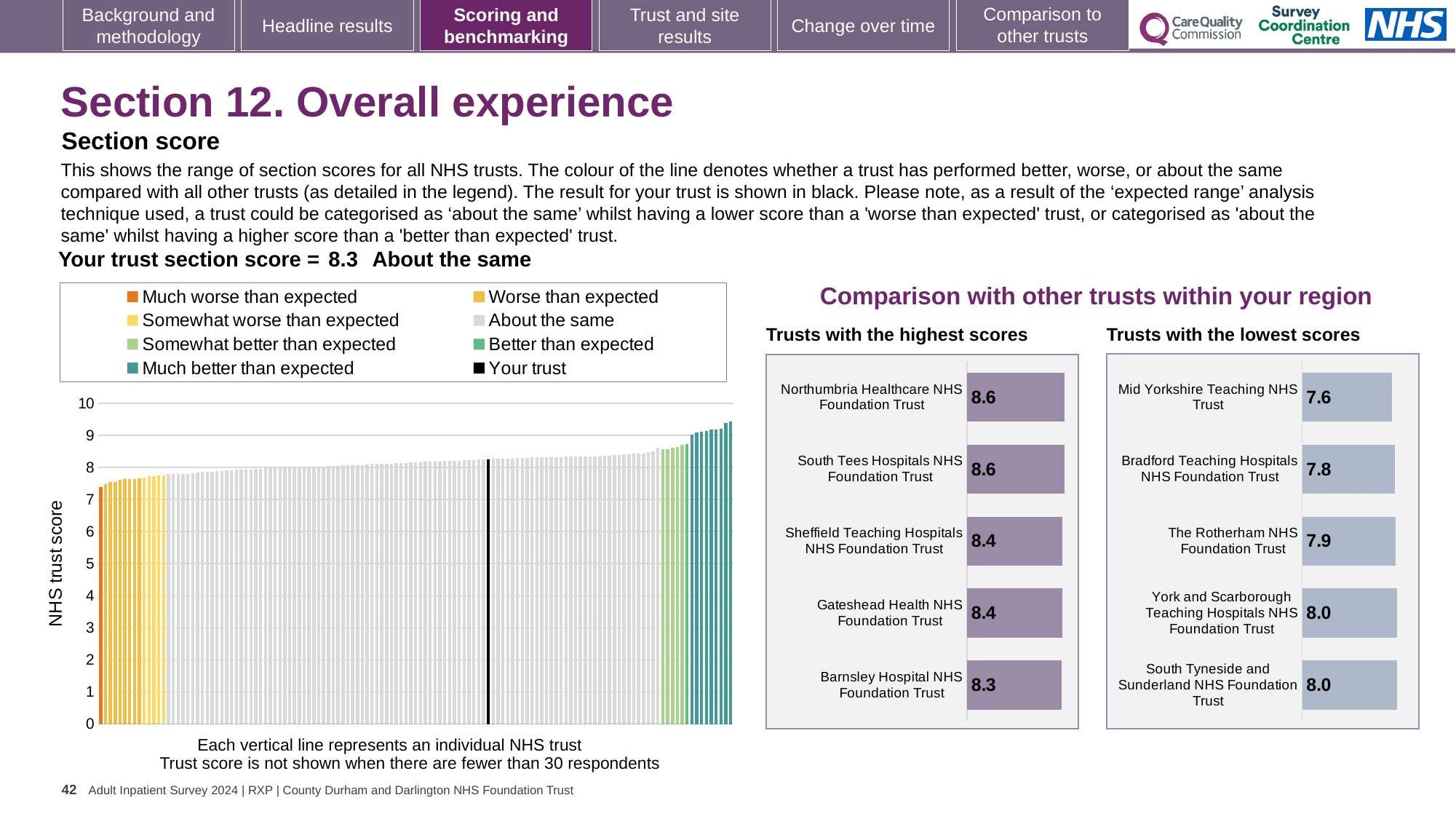
How many entries does the legend of the main chart on the left list? 8 In the 'Trusts with the highest scores' chart, which trust has the lowest score? Barnsley Hospital NHS Foundation Trust How many trusts are shown in the 'Trusts with the lowest scores' chart? 5 In the 'Trusts with the lowest scores' chart, what is the score for Mid Yorkshire Teaching NHS Trust? 7.6 In the 'Trusts with the lowest scores' chart, what is the score for Bradford Teaching Hospitals NHS Foundation Trust? 7.8 In the 'Trusts with the lowest scores' chart, which trust has the lowest score? Mid Yorkshire Teaching NHS Trust In the 'Trusts with the highest scores' chart, what is the score for Northumbria Healthcare NHS Foundation Trust? 8.6 In the 'Trusts with the highest scores' chart, what is the difference between the scores of Northumbria Healthcare NHS Foundation Trust and Barnsley Hospital NHS Foundation Trust? 0.3 In the 'Trusts with the highest scores' chart, what is the score for Sheffield Teaching Hospitals NHS Foundation Trust? 8.4 In the 'Trusts with the lowest scores' chart, which has the larger score: Bradford Teaching Hospitals NHS Foundation Trust or The Rotherham NHS Foundation Trust? The Rotherham NHS Foundation Trust In the main chart on the left, do the trust scores rise or fall from left to right? rise In the main chart on the left, what is the section score for your trust? 8.3